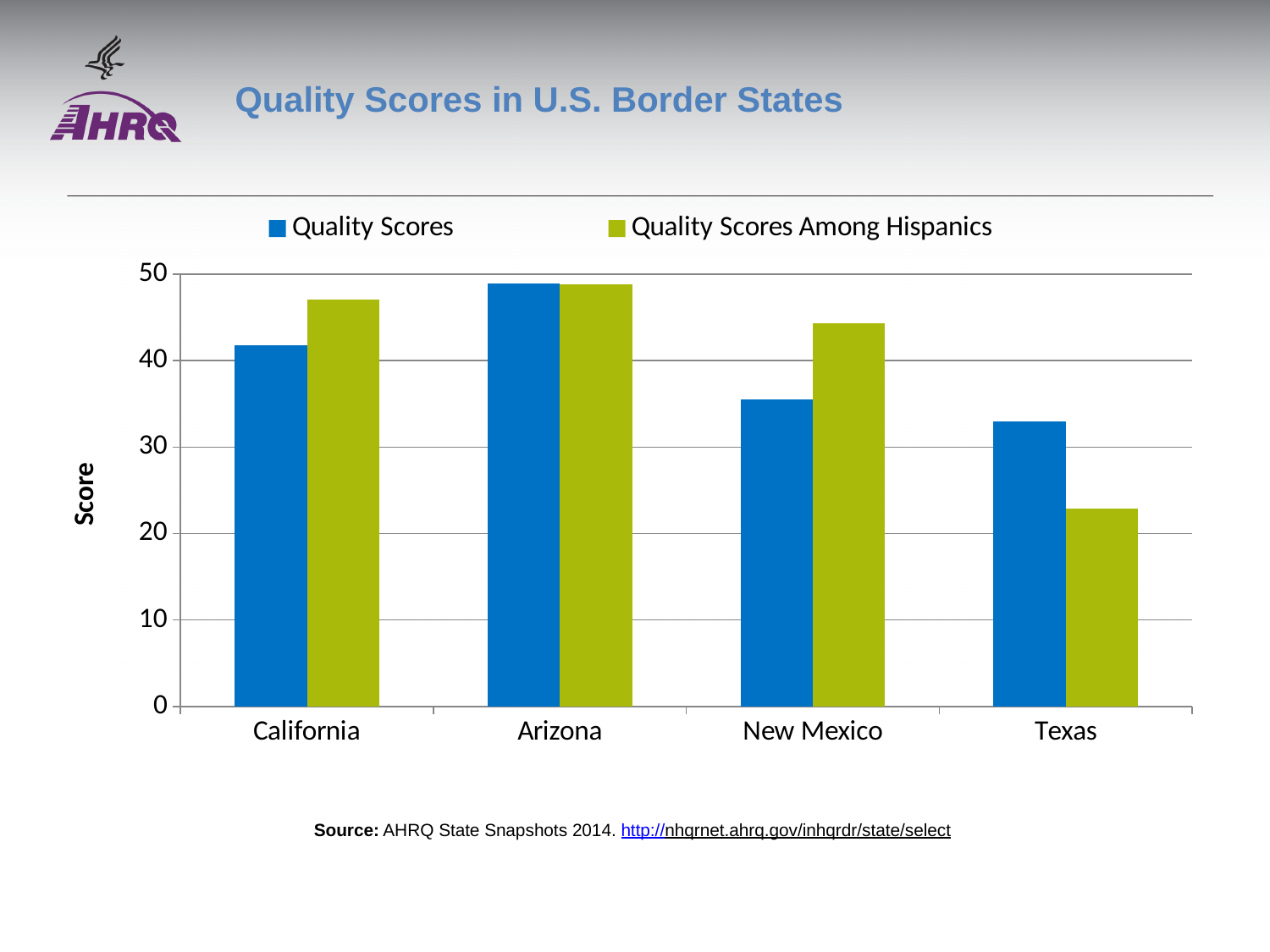
Is the Quality Scores Among Hispanics value for Texas greater or less than 30? less How many series does the legend list? 2 For Texas, which is larger: Quality Scores or Quality Scores Among Hispanics? Quality Scores What kind of chart is shown on the slide? bar chart For California, which is larger: Quality Scores or Quality Scores Among Hispanics? Quality Scores Among Hispanics What is the title of the chart? Quality Scores in U.S. Border States Which state has the highest Quality Scores value? Arizona Which state has the lowest Quality Scores Among Hispanics value? Texas Which state has the lowest Quality Scores value? Texas How many states are shown on the x axis? 4 Is the Quality Scores value for California greater or less than 40? greater Is the Quality Scores value for New Mexico greater or less than 40? less